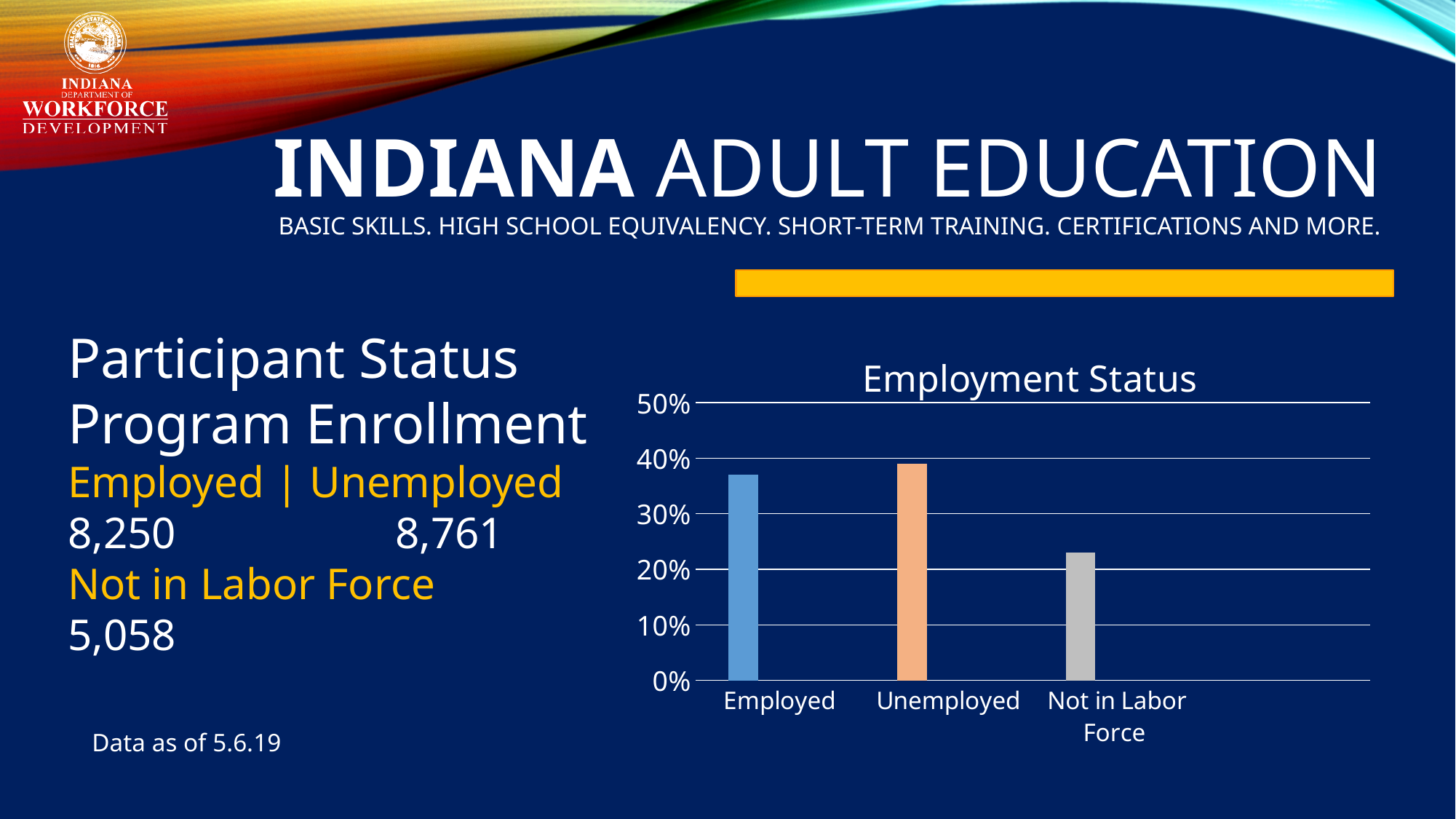
Is the value for Not in Labor Force greater or less than 30%? less Is the value for Employed greater or less than 40%? less Which is larger in the Employment Status chart, the value for Unemployed or the value for Not in Labor Force? Unemployed What type of chart is shown on the slide? bar chart How many categories are plotted in the Employment Status chart? 3 What is the title of the chart? Employment Status Which category has the highest bar in the Employment Status chart? Unemployed What colour is the bar for Not in Labor Force in the Employment Status chart? gray Is the value for Unemployed greater or less than 30%? greater Which category has the lowest bar in the Employment Status chart? Not in Labor Force